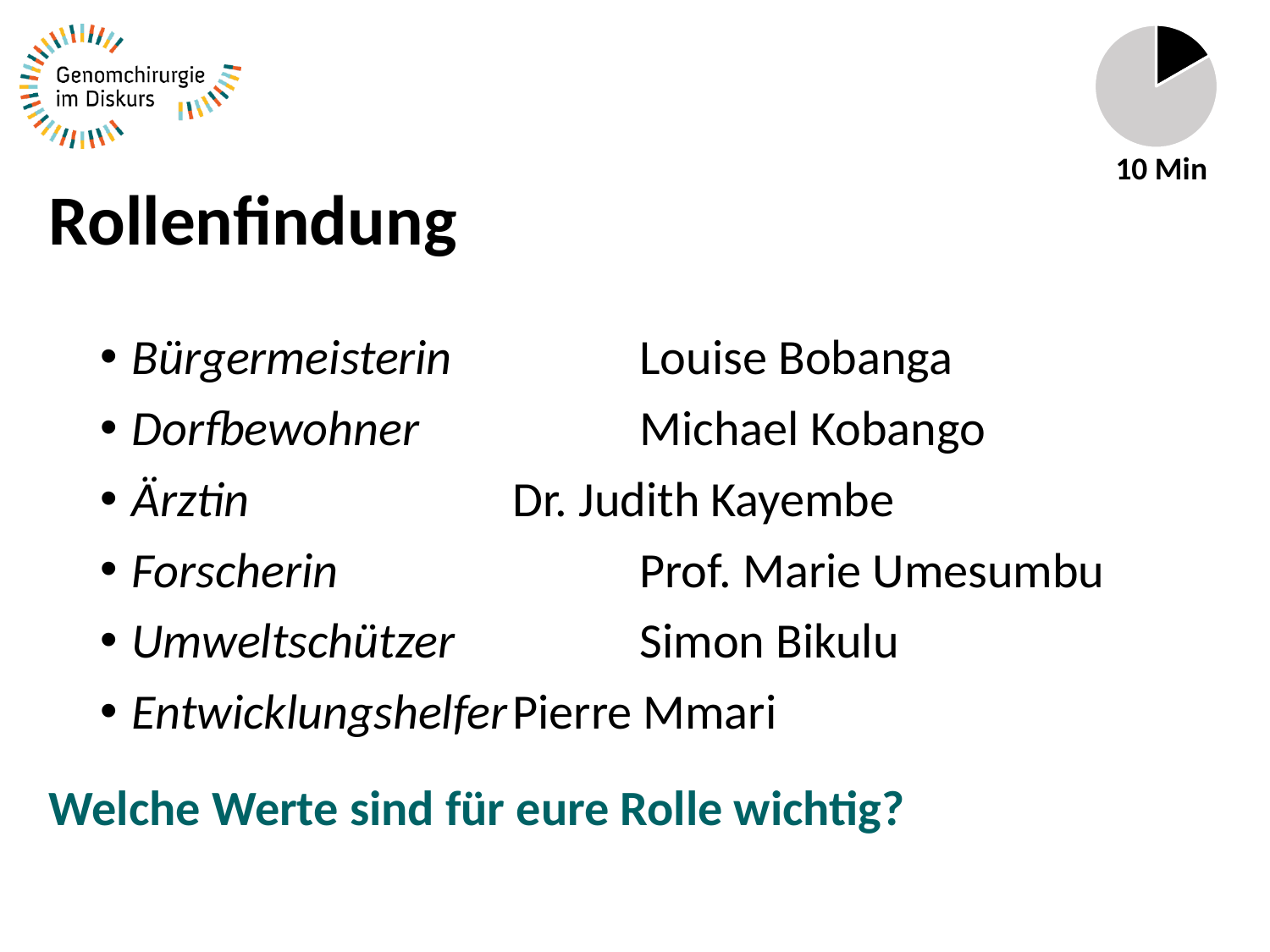
In the pie chart in the top right corner, which slice is larger, the black one or the grey one? the grey one Does the black slice of the pie chart in the top right corner cover more or less than half of the pie? less What kind of chart is shown in the top right corner of the slide? pie chart What label is printed directly below the pie chart in the top right corner? 10 Min How many slices does the pie chart in the top right corner have? 2